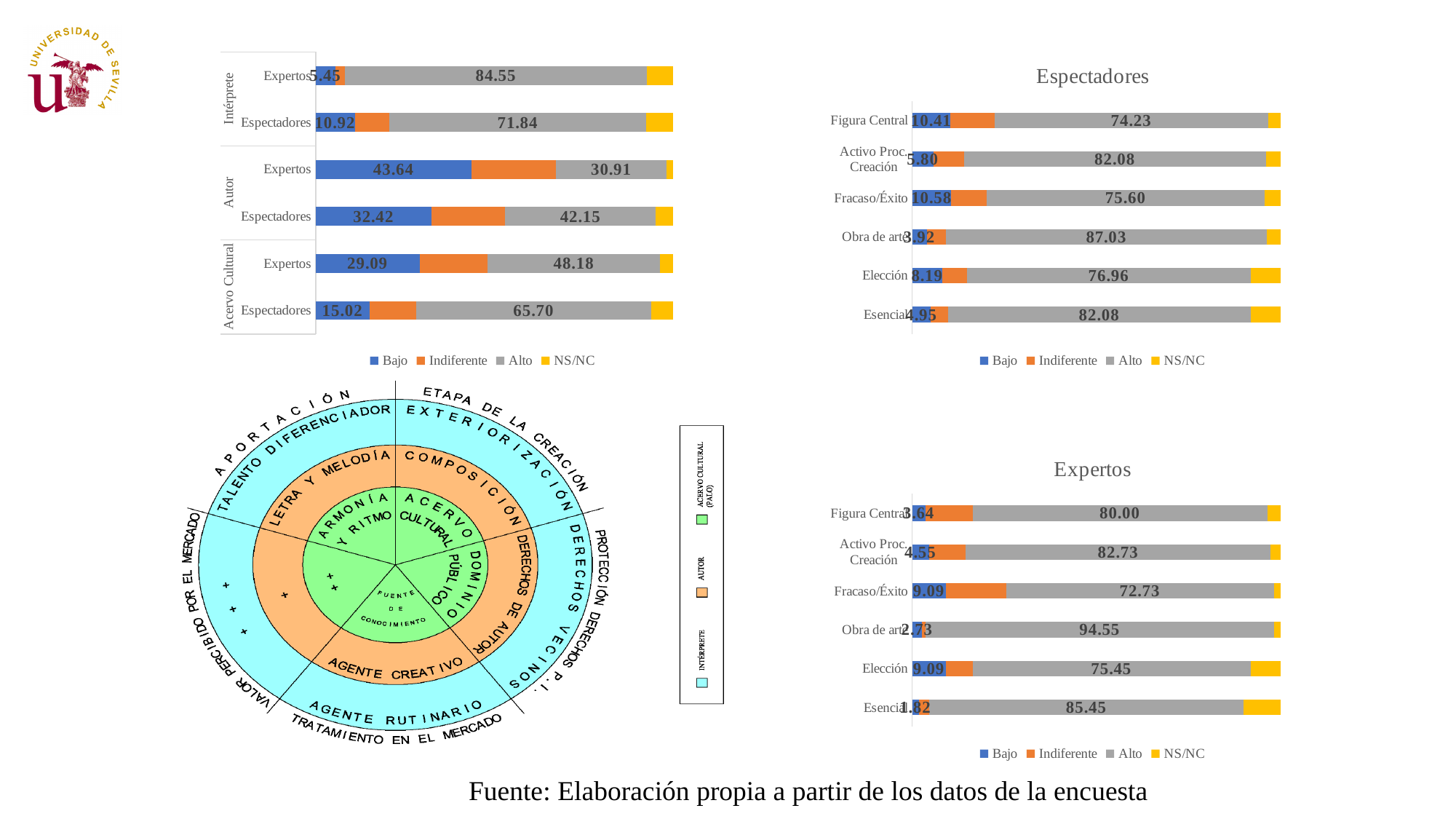
In the 'Expertos' chart, which category has the lowest Alto value? Fracaso/Éxito In the 'Espectadores' chart, what is the difference between the Alto values for Obra de arte and Figura Central? 12.80 How many categories are shown in the 'Espectadores' chart? 6 In the top-left bar chart, what is the Alto value for Expertos under Intérprete? 84.55 In the top-left bar chart, which has the larger Bajo value under Autor: Expertos or Espectadores? Expertos In the 'Expertos' chart, which category has the highest Alto value? Obra de arte In the 'Expertos' chart, what is the difference between the Alto values for Obra de arte and Fracaso/Éxito? 21.82 How many series does the legend of the 'Expertos' chart list? 4 In the top-left bar chart, what is the Bajo value for Expertos under Autor? 43.64 In the 'Espectadores' chart, which category has the highest Alto value? Obra de arte In the top-left bar chart, which bar has the lowest Alto value? Autor Expertos (30.91) In the 'Expertos' chart, what is the Alto value for Esencial? 85.45